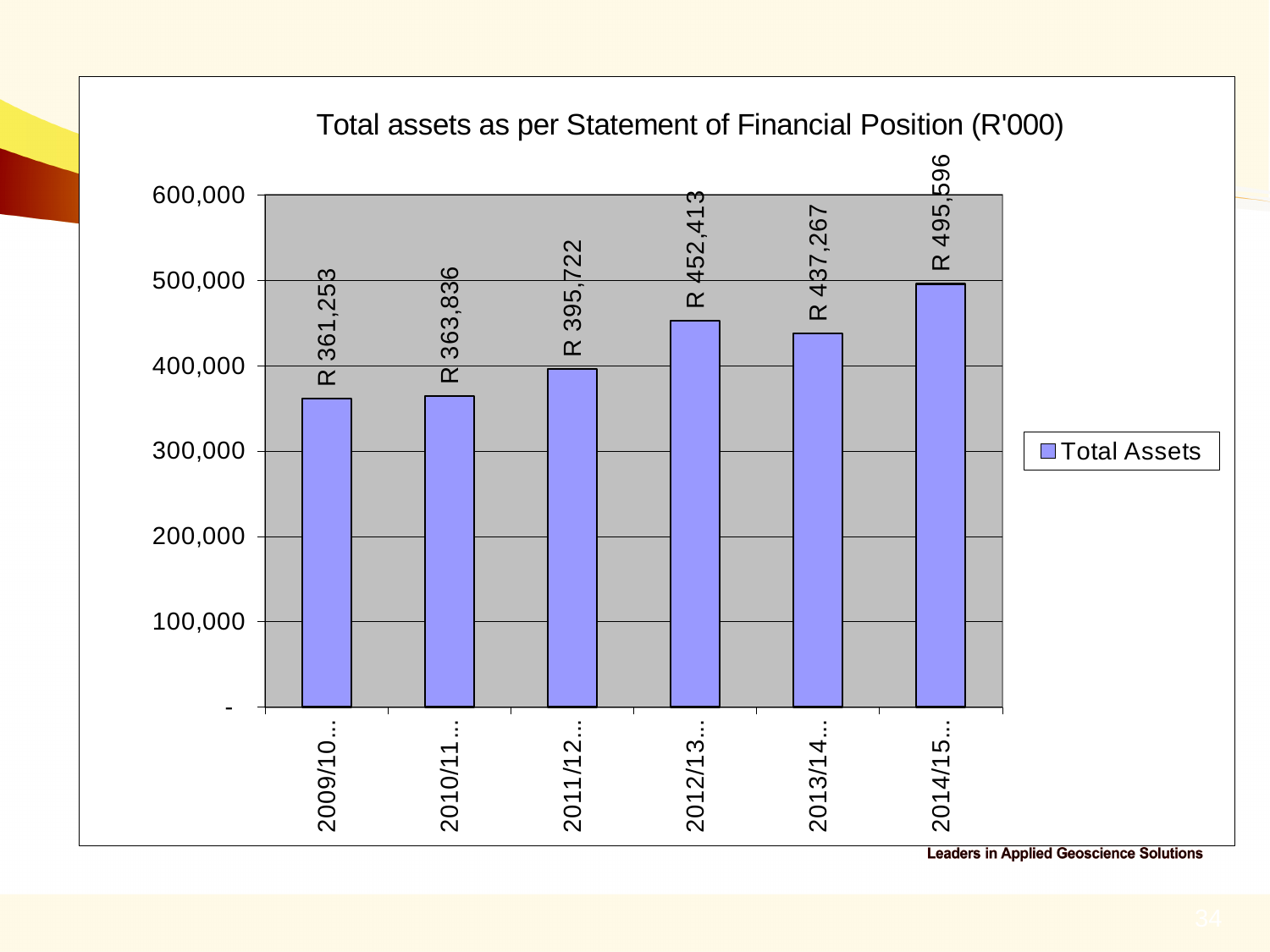
Which is larger, the value for 2012/13 or the value for 2013/14? 2012/13 What is the value for 2012/13? R 452,413 What kind of chart is this? bar chart What is the difference between the values for 2014/15 and 2013/14? 58,329 Is the value for 2011/12 greater or less than 400,000? less Which year has the lowest total assets? 2009/10 What is the difference between the values for 2012/13 and 2013/14? 15,146 How many years are shown on the x axis? 6 What is the title of the chart? Total assets as per Statement of Financial Position (R'000) What is the value for 2014/15? R 495,596 Which year has the highest total assets? 2014/15 What is the value for 2009/10? R 361,253